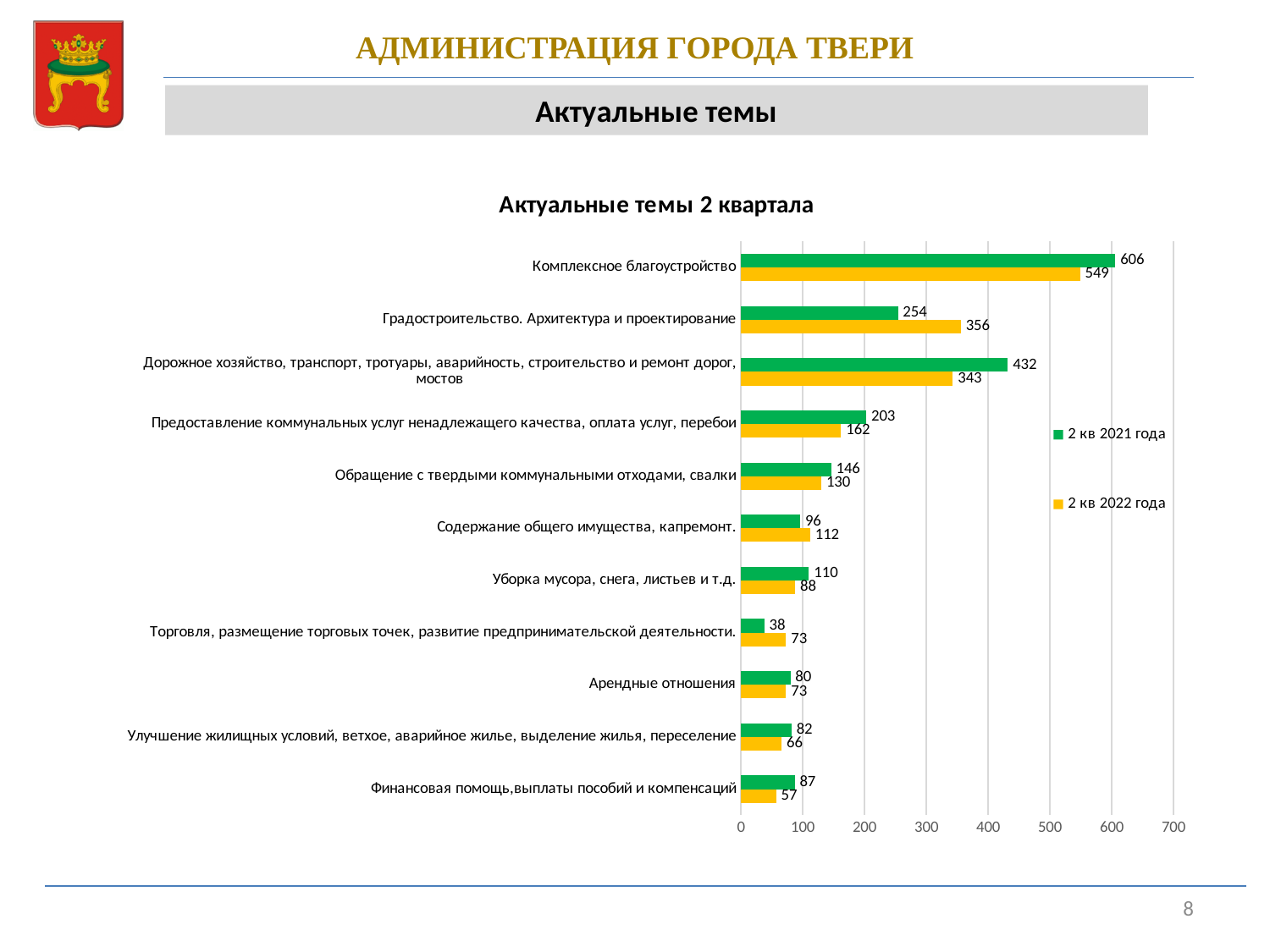
What is the difference between the 2 кв 2021 года and 2 кв 2022 года values for Дорожное хозяйство, транспорт, тротуары, аварийность, строительство и ремонт дорог, мостов? 89 How many series does the legend list? 2 How many categories are shown in the chart? 11 What is the value for Торговля, размещение торговых точек, развитие предпринимательской деятельности in 2 кв 2021 года? 38 What is the value for Градостроительство. Архитектура и проектирование in 2 кв 2022 года? 356 What is the value for Комплексное благоустройство in 2 кв 2021 года? 606 What is the title of the chart? Актуальные темы 2 квартала Which colour represents the 2 кв 2022 года series? yellow What type of chart is shown on the slide? bar chart Which category has the highest value in 2 кв 2022 года? Комплексное благоустройство For Содержание общего имущества, капремонт, which series has the larger value: 2 кв 2021 года or 2 кв 2022 года? 2 кв 2022 года Which category has the lowest value in 2 кв 2021 года? Торговля, размещение торговых точек, развитие предпринимательской деятельности